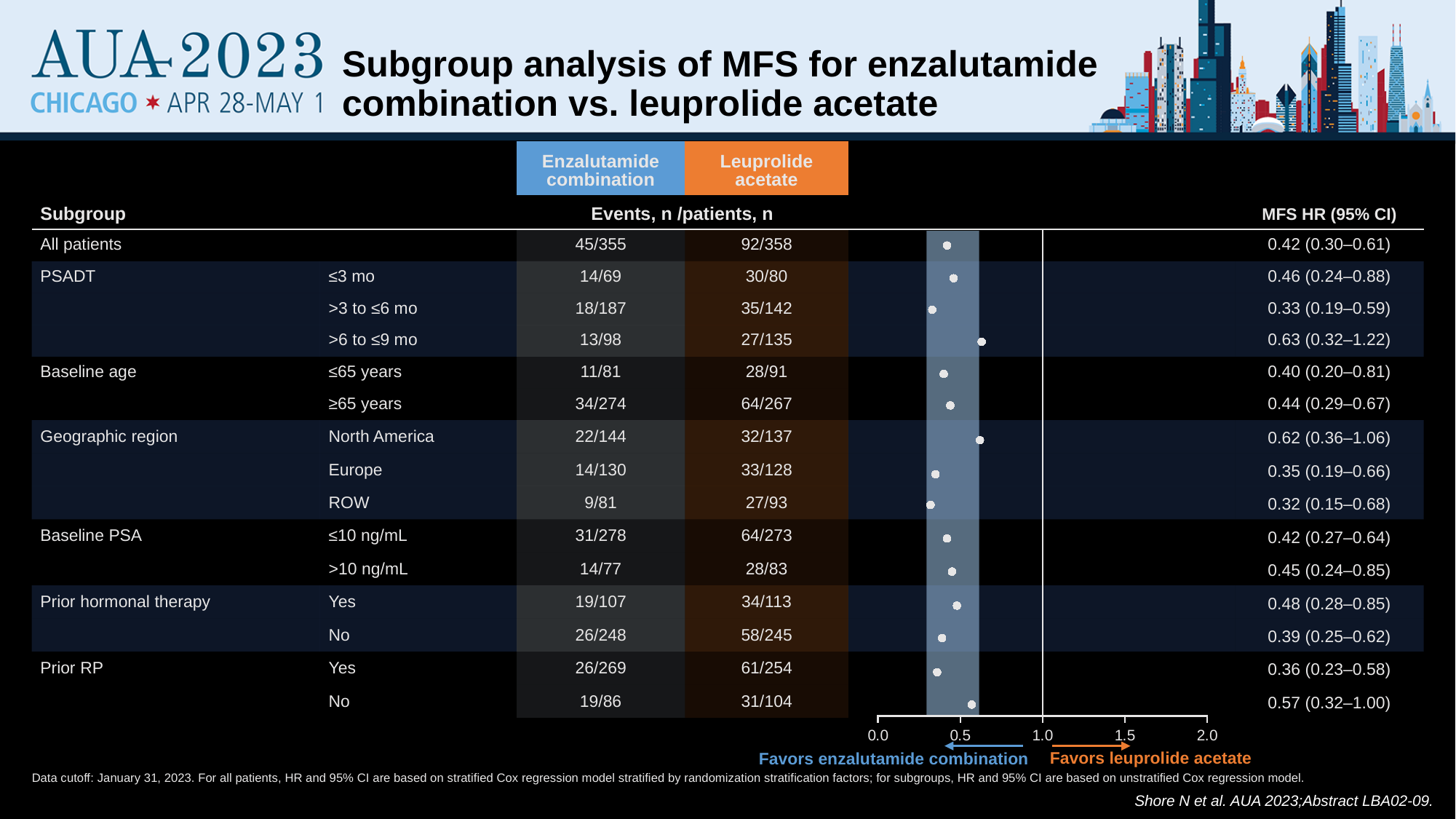
What is the events/patients value for the enzalutamide combination arm in all patients? 45/355 Which treatment does the left side of the hazard ratio axis favor? Enzalutamide combination Is the MFS hazard ratio for the Prior RP No subgroup greater or less than 1.0? less What is the maximum value shown on the hazard ratio axis? 2.0 What kind of chart is shown on the slide? Forest plot What is the difference between the MFS hazard ratio for the >6 to ≤9 mo PSADT subgroup and the ROW subgroup? 0.31 Which has the larger MFS hazard ratio, Europe or North America? North America How many subgroup rows (including all patients) are plotted in the forest plot? 15 Which subgroup has the highest MFS hazard ratio? >6 to ≤9 mo Which subgroup has the lowest MFS hazard ratio? ROW What is the MFS HR (95% CI) for all patients? 0.42 (0.30–0.61) What is the MFS hazard ratio for the North America subgroup? 0.62